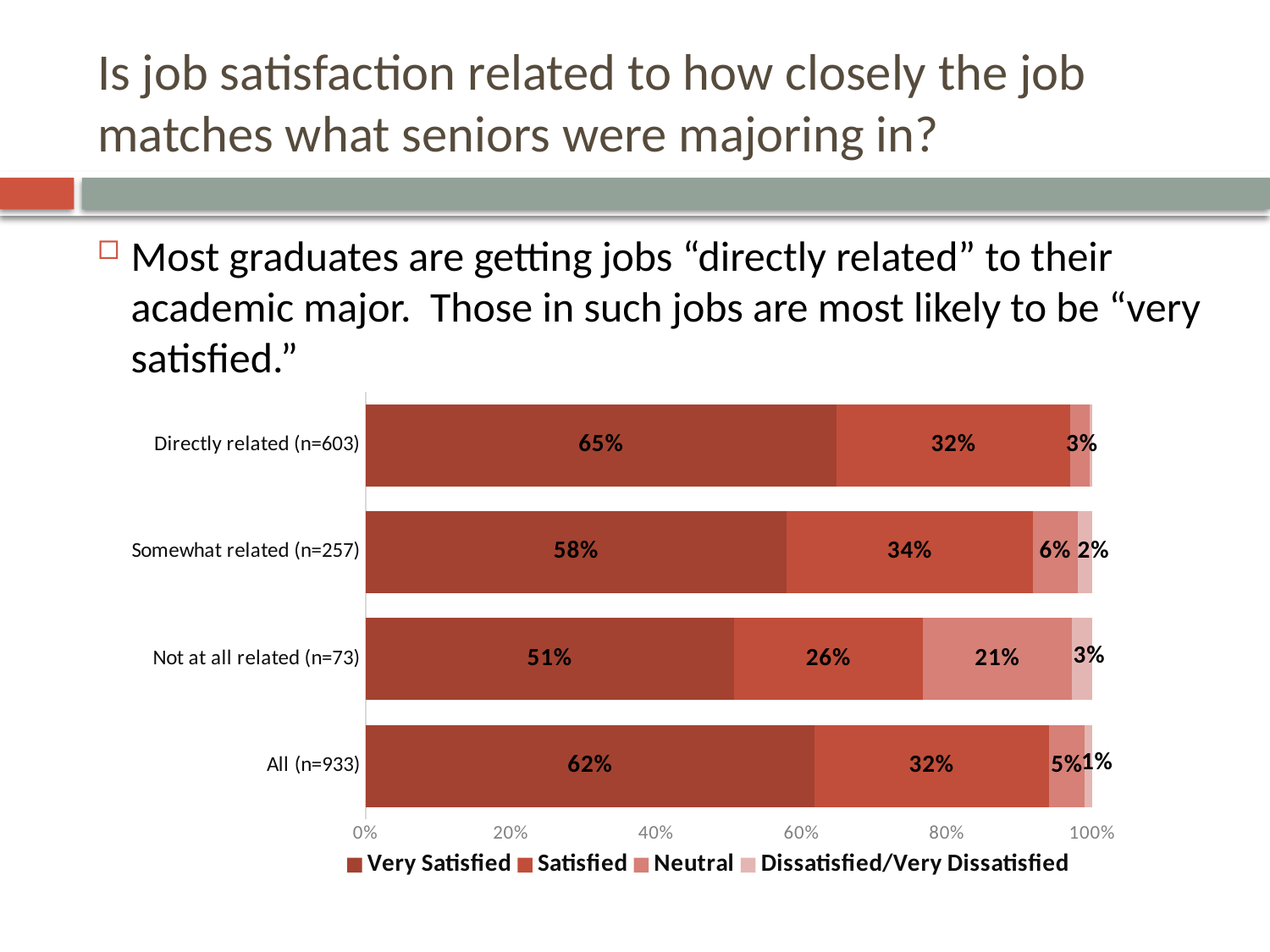
What percentage of graduates in jobs directly related (n=603) to their major are Very Satisfied? 65% How many percentage points higher is the Very Satisfied share for Directly related (n=603) than for Not at all related (n=73)? 14 percentage points How many categories are shown on the chart? 4 What percentage of graduates in jobs somewhat related (n=257) to their major are Satisfied? 34% Which category has the lowest Very Satisfied percentage? Not at all related (n=73) Which category has the highest Very Satisfied percentage? Directly related (n=603) What is the Very Satisfied percentage for the All (n=933) group? 62% Which has a larger Satisfied percentage: Somewhat related (n=257) or Not at all related (n=73)? Somewhat related (n=257) What is the last entry in the chart's legend? Dissatisfied/Very Dissatisfied What percentage of graduates in jobs not at all related (n=73) to their major are Neutral? 21% What kind of chart is shown on the slide? Stacked bar chart How many series does the legend list? 4